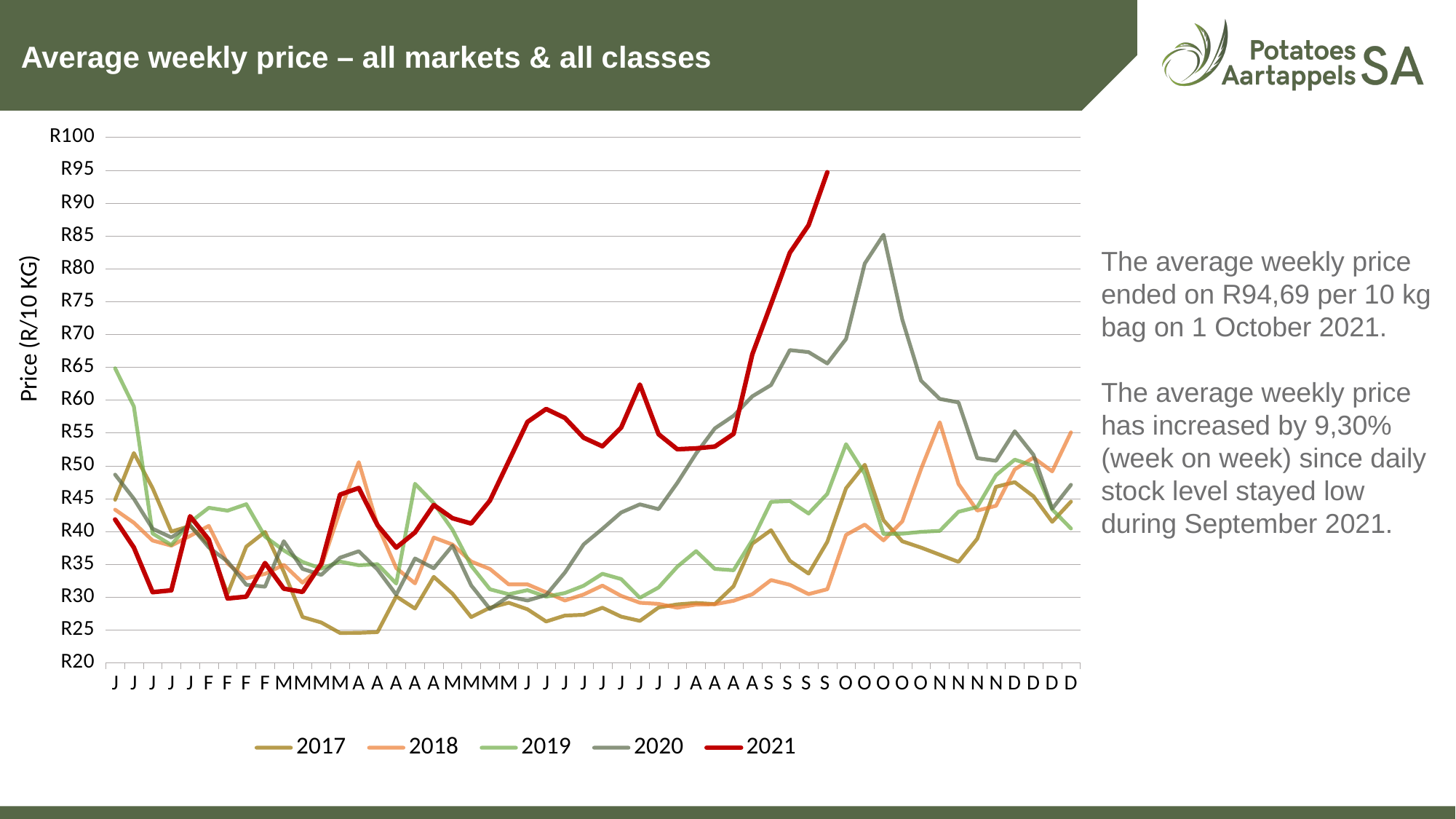
What is the label on the vertical axis of the chart? Price (R/10 KG) At the start of January, which series is higher, 2019 or 2017? 2019 What kind of chart is shown on the slide? line chart How many series does the legend list? 5 Is the first value of the 2019 series in January greater or less than R60? greater Is the final value of the 2021 series greater or less than R90? greater Is the lowest value of the 2017 series in April greater or less than R30? less At the end of December, which series is higher, 2018 or 2019? 2018 Which series reaches the highest value on the chart? 2021 Does the 2021 series rise or fall from July to the end of September? rise What is the title of the chart? Average weekly price – all markets & all classes